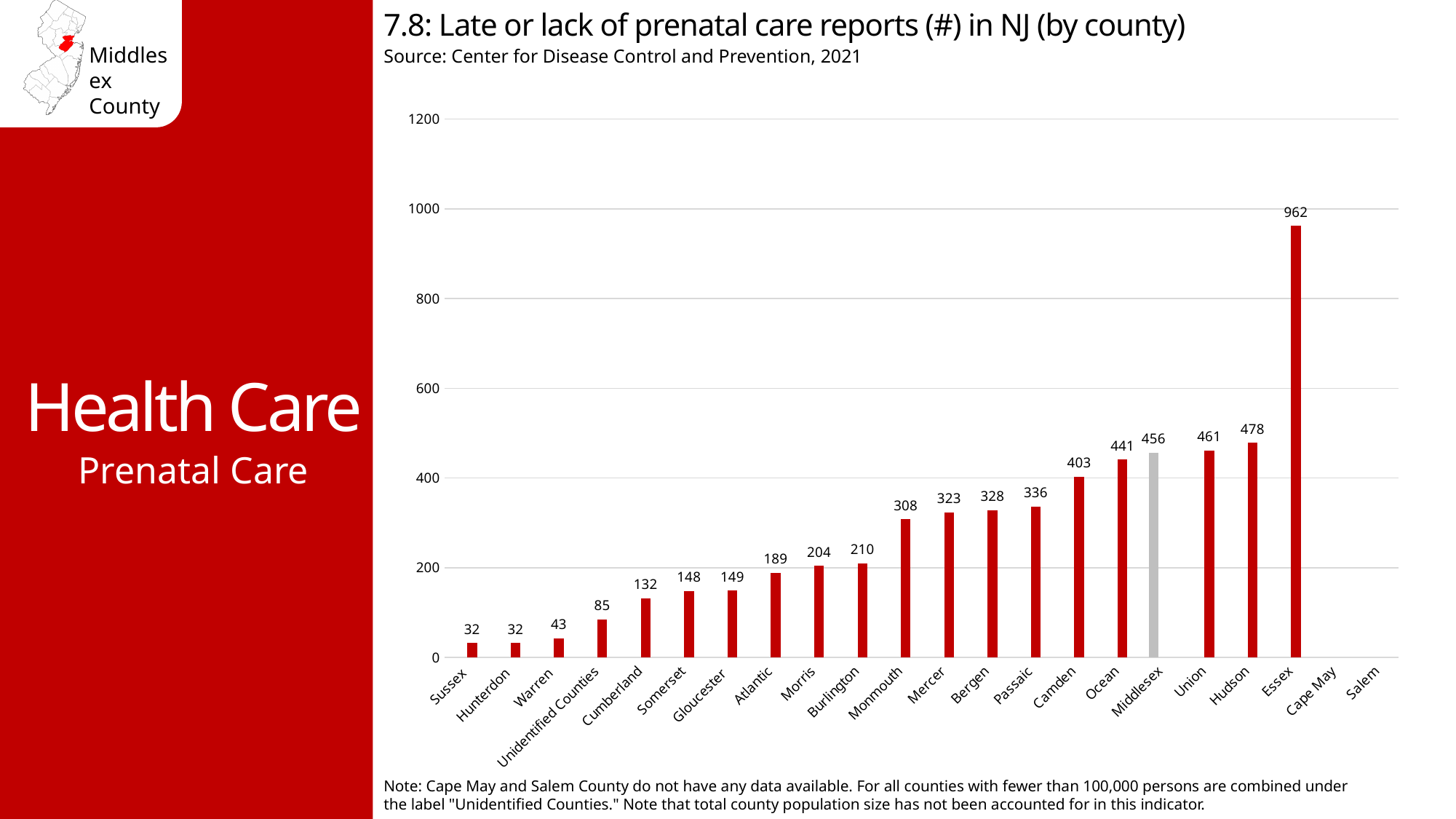
How many counties (categories) are listed along the x axis? 22 Do the values generally rise or fall from Sussex to Essex along the x axis? Rise Which bar is coloured grey instead of red? Middlesex Which county has the highest number of late or lack of prenatal care reports? Essex What is the value shown for Essex? 962 Is the value for Monmouth greater or less than 400? less What is the difference between the values for Middlesex and Ocean? 15 What is the value shown for Cumberland? 132 Which is larger, the value for Camden or the value for Passaic? Camden What is the difference between the values for Essex and Hudson? 484 What kind of chart is shown on the slide? Bar chart What is the number of late or lack of prenatal care reports for Middlesex? 456